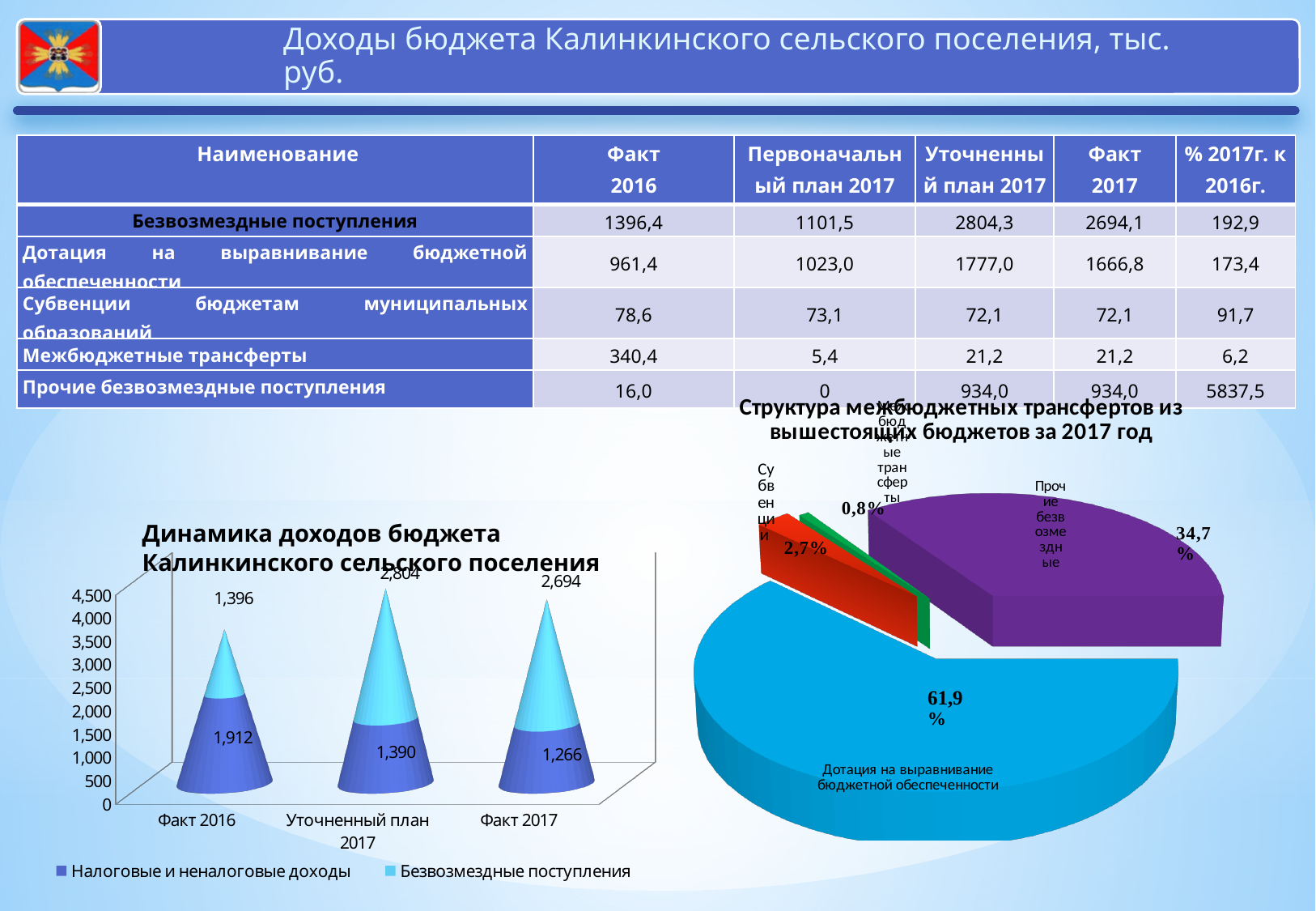
What kind of chart is 'Структура межбюджетных трансфертов из вышестоящих бюджетов за 2017 год'? pie chart In the chart 'Динамика доходов бюджета Калинкинского сельского поселения', what is the value of Безвозмездные поступления for Факт 2017? 2,694 In the chart 'Динамика доходов бюджета Калинкинского сельского поселения', which category has the lowest value for Налоговые и неналоговые доходы? Факт 2017 In the chart 'Динамика доходов бюджета Калинкинского сельского поселения', does the value of Налоговые и неналоговые доходы rise or fall from Факт 2016 to Факт 2017? fall In the chart 'Динамика доходов бюджета Калинкинского сельского поселения', how many series does the legend list? 2 In the chart 'Динамика доходов бюджета Калинкинского сельского поселения', what is the value of Безвозмездные поступления for Уточненный план 2017? 2,804 In the chart 'Динамика доходов бюджета Калинкинского сельского поселения', what is the total of the two series for Уточненный план 2017? 4,194 In the chart 'Динамика доходов бюджета Калинкинского сельского поселения', what is the value of Налоговые и неналоговые доходы for Факт 2016? 1,912 In the pie chart 'Структура межбюджетных трансфертов из вышестоящих бюджетов за 2017 год', which slice is the smallest? Межбюджетные трансферты In the pie chart 'Структура межбюджетных трансфертов из вышестоящих бюджетов за 2017 год', what share does Субвенции have? 2,7% In the pie chart 'Структура межбюджетных трансфертов из вышестоящих бюджетов за 2017 год', what share does Дотация на выравнивание бюджетной обеспеченности have? 61,9% In the chart 'Динамика доходов бюджета Калинкинского сельского поселения', what is the difference between Налоговые и неналоговые доходы for Факт 2016 and for Факт 2017? 646